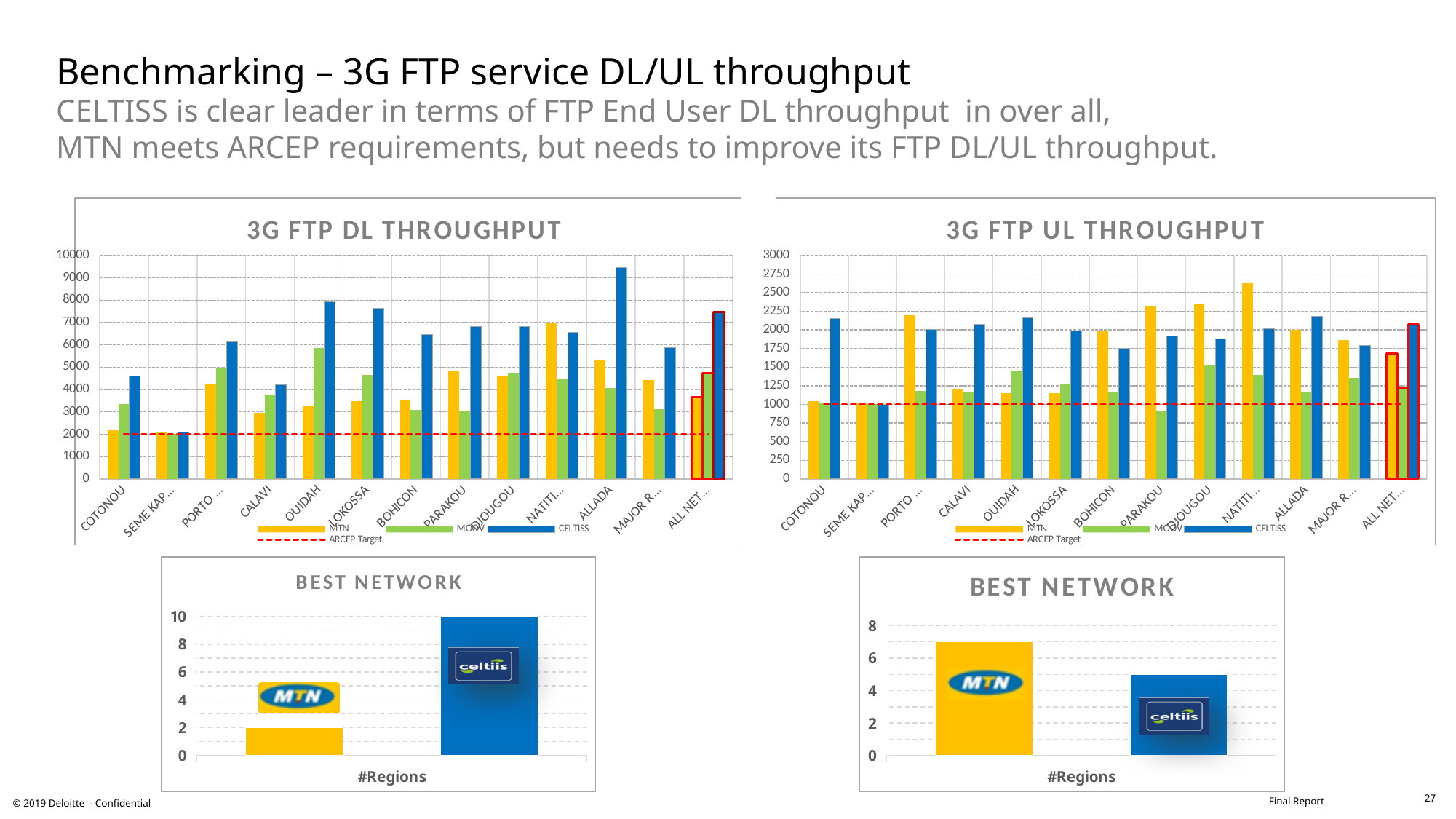
In the bottom-right BEST NETWORK chart, is the value for CELTIIS greater or less than 4? greater In the 3G FTP DL THROUGHPUT chart, in which region is the CELTISS value highest? ALLADA In the bottom-left BEST NETWORK chart, what is the difference between the CELTIIS and MTN values? 8 In the bottom-left BEST NETWORK chart, what is the value for MTN? 2 In the bottom-right BEST NETWORK chart, is the value for MTN greater or less than 6? greater In the 3G FTP UL THROUGHPUT chart, is the MTN value for PARAKOU greater or less than 2000? greater In the bottom-right BEST NETWORK chart, which network has the larger value, MTN or CELTIIS? MTN How many regions (categories) are shown on the x axis of the 3G FTP DL THROUGHPUT chart? 13 In the bottom-left BEST NETWORK chart, what is the value for CELTIIS? 10 What kind of chart is the 3G FTP UL THROUGHPUT chart? Combination bar and line chart (bars with a dashed ARCEP Target line) How many series does the legend of the 3G FTP UL THROUGHPUT chart list? 4